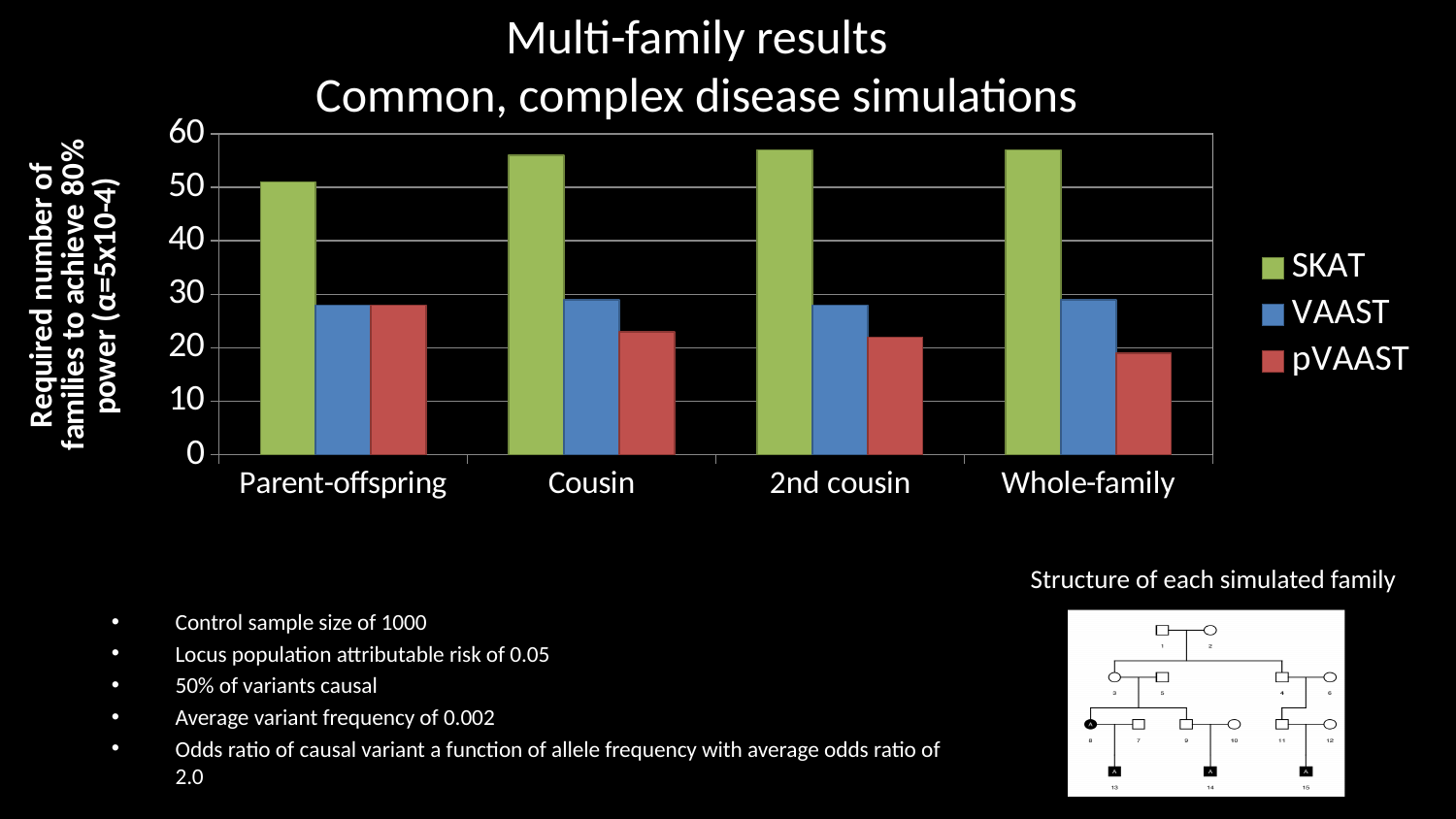
Which series has the highest value in the Whole-family category? SKAT What kind of chart is shown on the slide? bar chart Is the pVAAST value for Cousin greater or less than 20? greater In which category is the pVAAST value lowest? Whole-family Is the SKAT value for Cousin greater or less than 50? greater Which is larger in the Cousin category, VAAST or pVAAST? VAAST Do the pVAAST values rise or fall from Parent-offspring to Whole-family? fall Which series has the lowest value in the Whole-family category? pVAAST Is the SKAT value for 2nd cousin greater or less than 60? less In which category is the SKAT value lowest? Parent-offspring How many family-structure categories are shown on the x axis? 4 How many series does the legend list? 3